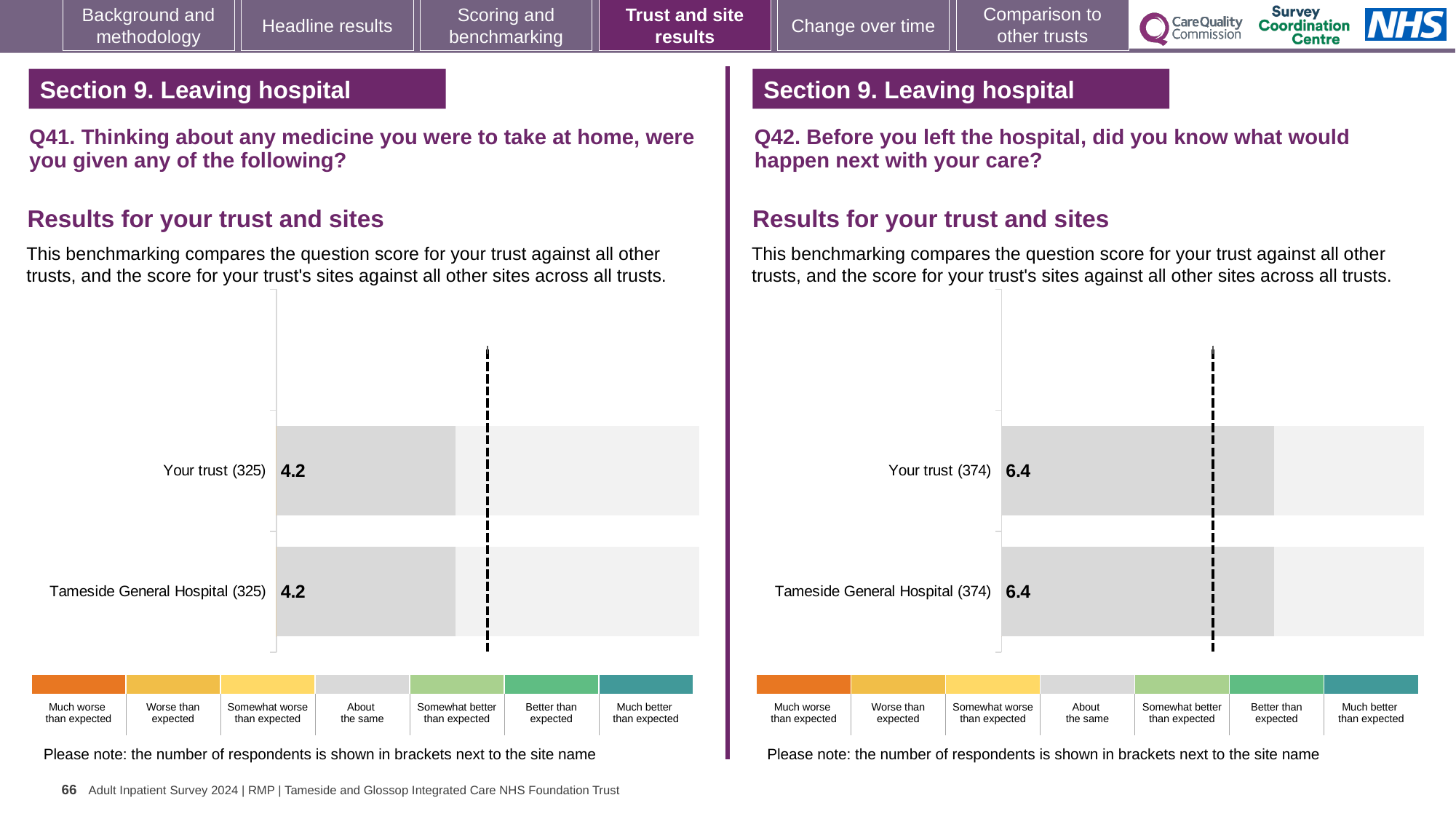
In the Q42 chart on the right, how many respondents are shown in brackets next to Tameside General Hospital? 374 In the Q41 chart on the left, what is the score for Tameside General Hospital? 4.2 In the Q42 chart on the right, what is the score for Your trust? 6.4 In the Q41 chart on the left, what is the difference between the score for Your trust and the score for Tameside General Hospital? 0 How many bars are plotted in the Q42 chart on the right? 2 In the Q41 chart on the left, what is the score for Your trust? 4.2 In the Q42 chart on the right, what is the score for Tameside General Hospital? 6.4 In the Q42 chart on the right, what is the difference between the score for Your trust and the score for Tameside General Hospital? 0 What kind of chart is used for the Q41 results on the left? Bar chart How many bars are plotted in the Q41 chart on the left? 2 In the Q41 chart on the left, how many respondents are shown in brackets next to Your trust? 325 Is the score for Your trust in the Q42 chart on the right larger than the score for Your trust in the Q41 chart on the left? Yes